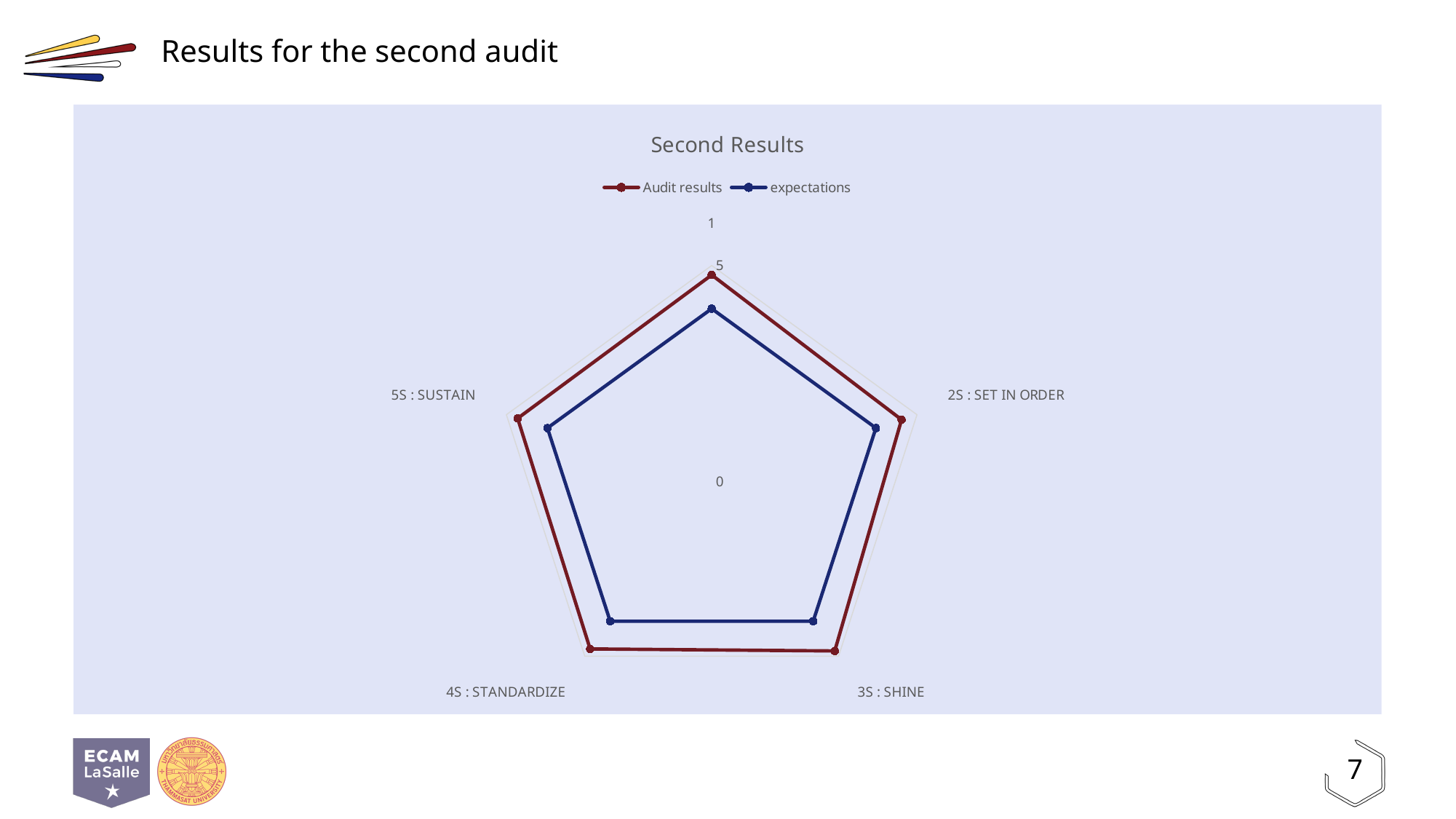
For 3S : SHINE, which series has the larger value, Audit results or expectations? Audit results How many categories (axes) does the radar chart have? 5 Which series is drawn in dark red? Audit results For 4S : STANDARDIZE, which series has the larger value, Audit results or expectations? Audit results How many series does the legend list? 2 Is the expectations value for 5S : SUSTAIN greater or less than 0? greater What kind of chart is shown on the slide? Radar chart Is the expectations value for 2S : SET IN ORDER greater or less than 5? less What is the title of the chart? Second Results